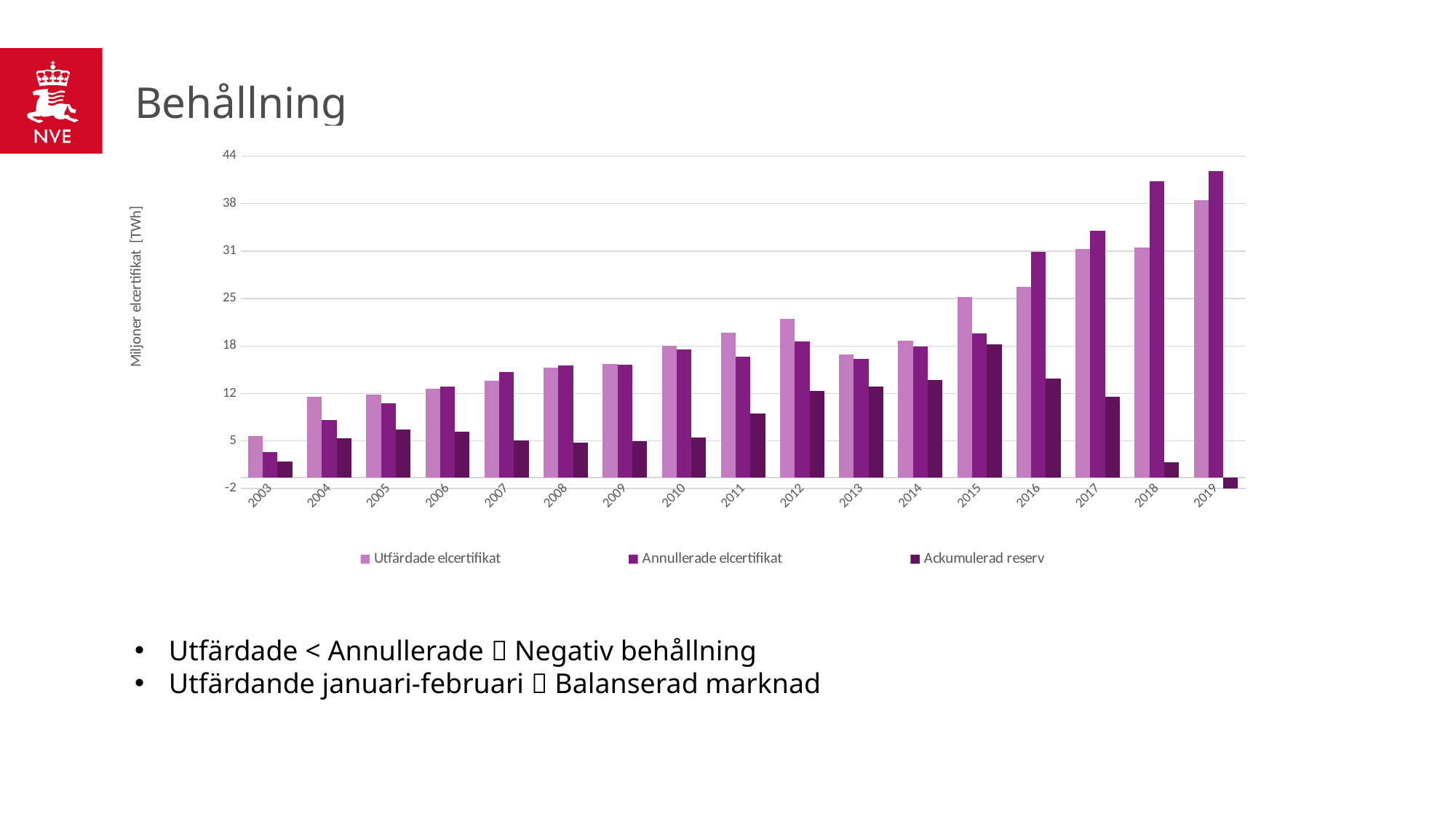
How many series does the legend list? 3 In 2019, which is larger: Utfärdade elcertifikat or Annullerade elcertifikat? Annullerade elcertifikat In which year is Utfärdade elcertifikat highest? 2019 In which year is Annullerade elcertifikat highest? 2019 Do the values for Utfärdade elcertifikat generally rise or fall from 2003 to 2019? rise What kind of chart is shown on the slide? bar chart In 2003, which is larger: Utfärdade elcertifikat or Annullerade elcertifikat? Utfärdade elcertifikat Is the value for Annullerade elcertifikat in 2018 greater or less than 38? greater Is the value for Ackumulerad reserv in 2011 greater or less than 12? less Is the value for Utfärdade elcertifikat in 2016 greater or less than 25? greater In which year is Ackumulerad reserv lowest? 2019 How many years are shown on the x axis? 17